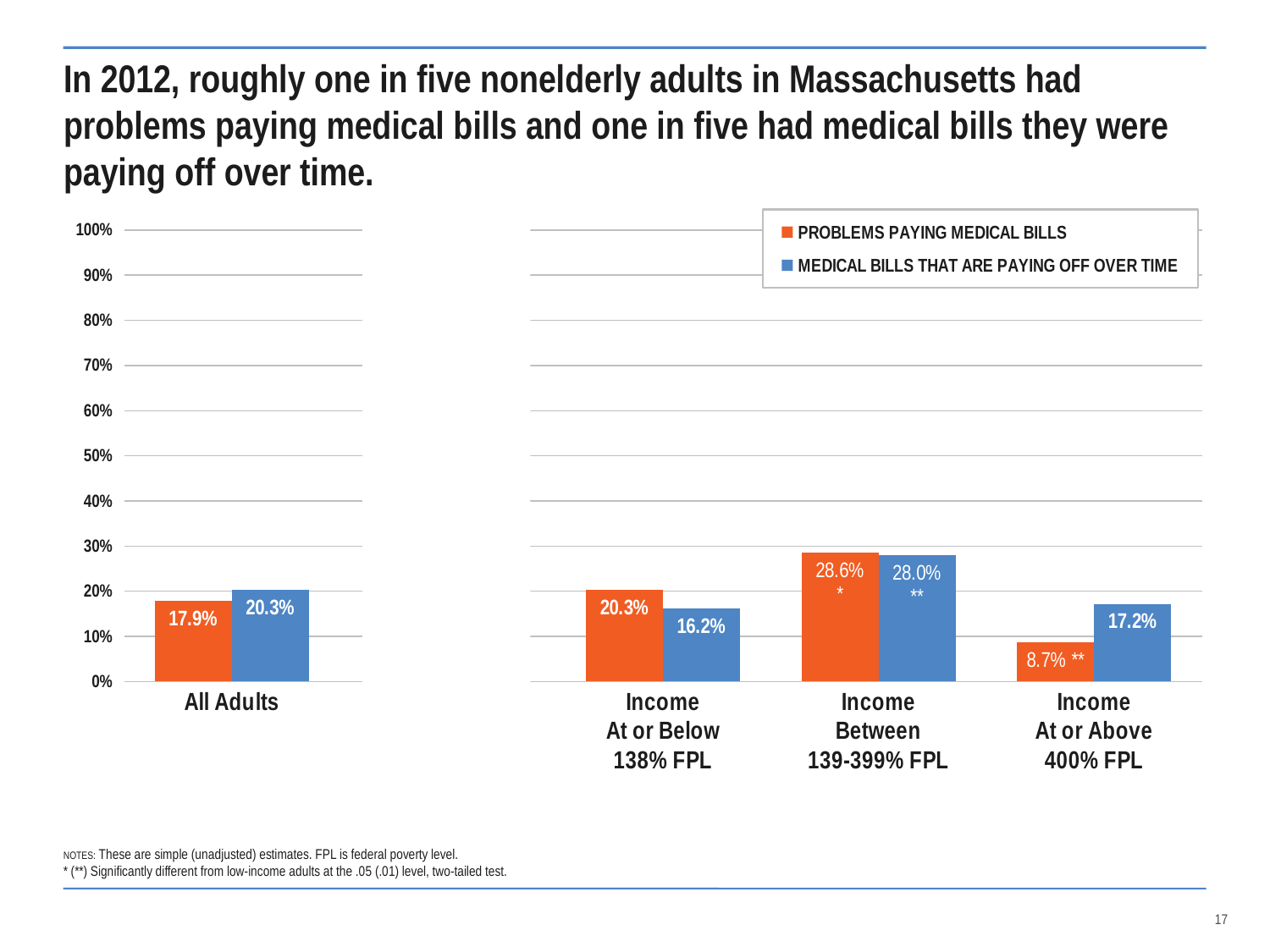
In the right-hand chart, is the value for Problems Paying Medical Bills for Income At or Above 400% FPL greater or less than 10%? less In the right-hand chart, what is the value for Problems Paying Medical Bills for Income At or Above 400% FPL? 8.7% In the right-hand chart, what is the value for Problems Paying Medical Bills for Income Between 139-399% FPL? 28.6% In the right-hand chart, what is the value for Medical Bills That Are Paying Off Over Time for Income At or Below 138% FPL? 16.2% What kind of chart is the right-hand chart? Bar chart In the left-hand chart, which is larger for All Adults: Problems Paying Medical Bills or Medical Bills That Are Paying Off Over Time? Medical Bills That Are Paying Off Over Time How many series does the legend list? 2 In the right-hand chart, which income group has the lowest value for Medical Bills That Are Paying Off Over Time? Income At or Below 138% FPL In the right-hand chart, what is the difference between Medical Bills That Are Paying Off Over Time and Problems Paying Medical Bills for Income At or Above 400% FPL? 8.5% How many income groups are shown on the x axis of the right-hand chart? 3 In the right-hand chart, which income group has the highest value for Problems Paying Medical Bills? Income Between 139-399% FPL In the left-hand chart, what is the value for Medical Bills That Are Paying Off Over Time for All Adults? 20.3%